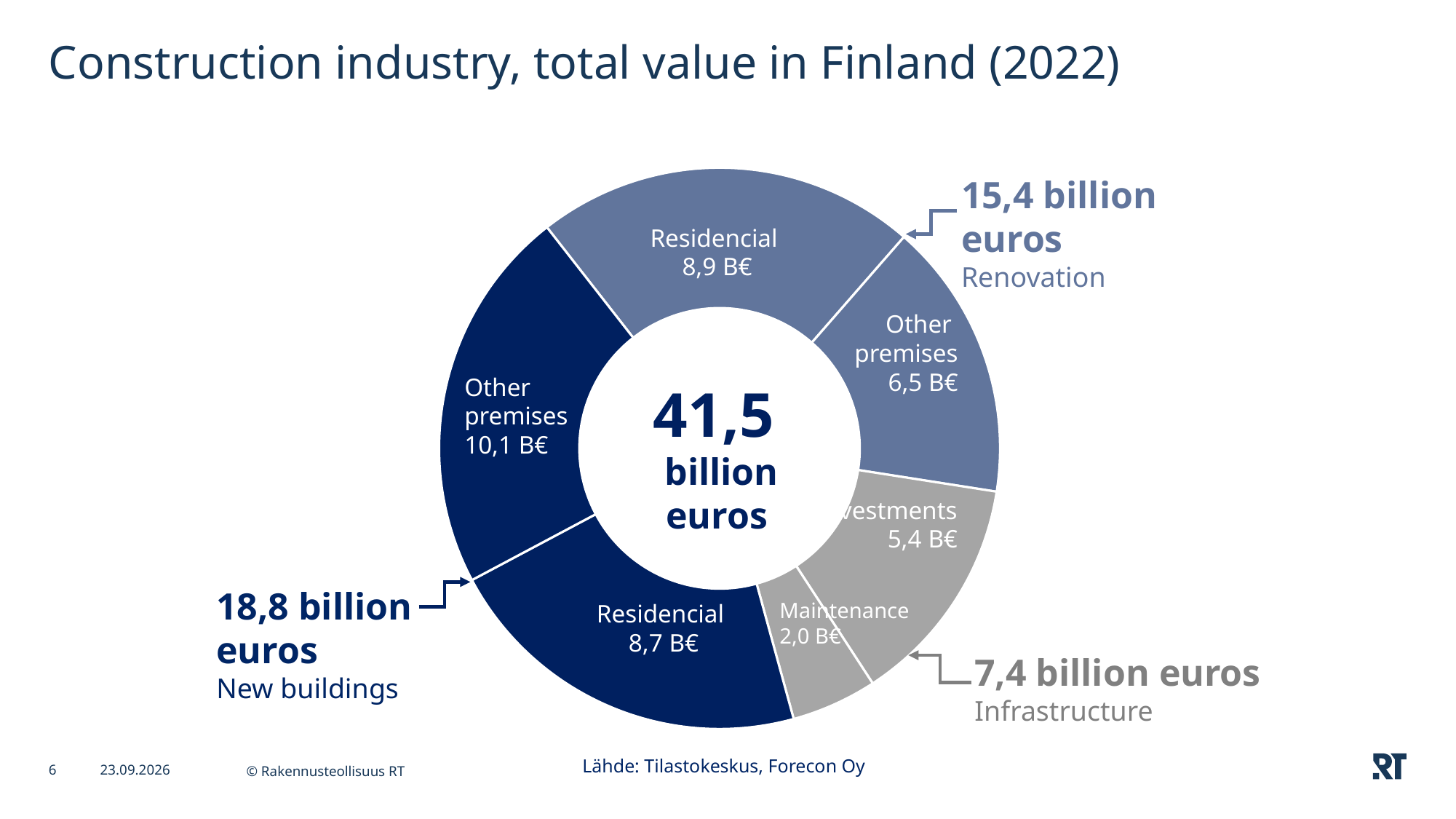
Which segment of the chart has the largest value? Other premises (New buildings), 10,1 B€ What is the value of the Maintenance segment? 2,0 B€ What is the value of the Residencial segment within Renovation? 8,9 B€ What kind of chart is shown on the slide? donut (pie) chart How much larger is the New buildings total than the Renovation total? 3,4 billion euros What is the total value for New buildings? 18,8 billion euros What is the total value shown in the centre of the chart? 41,5 billion euros How many segments does the donut chart have? 6 Which segment of the chart has the smallest value? Maintenance, 2,0 B€ What is the value of the Other premises segment within New buildings? 10,1 B€ What is the total value for Renovation? 15,4 billion euros What is the total value for Infrastructure? 7,4 billion euros